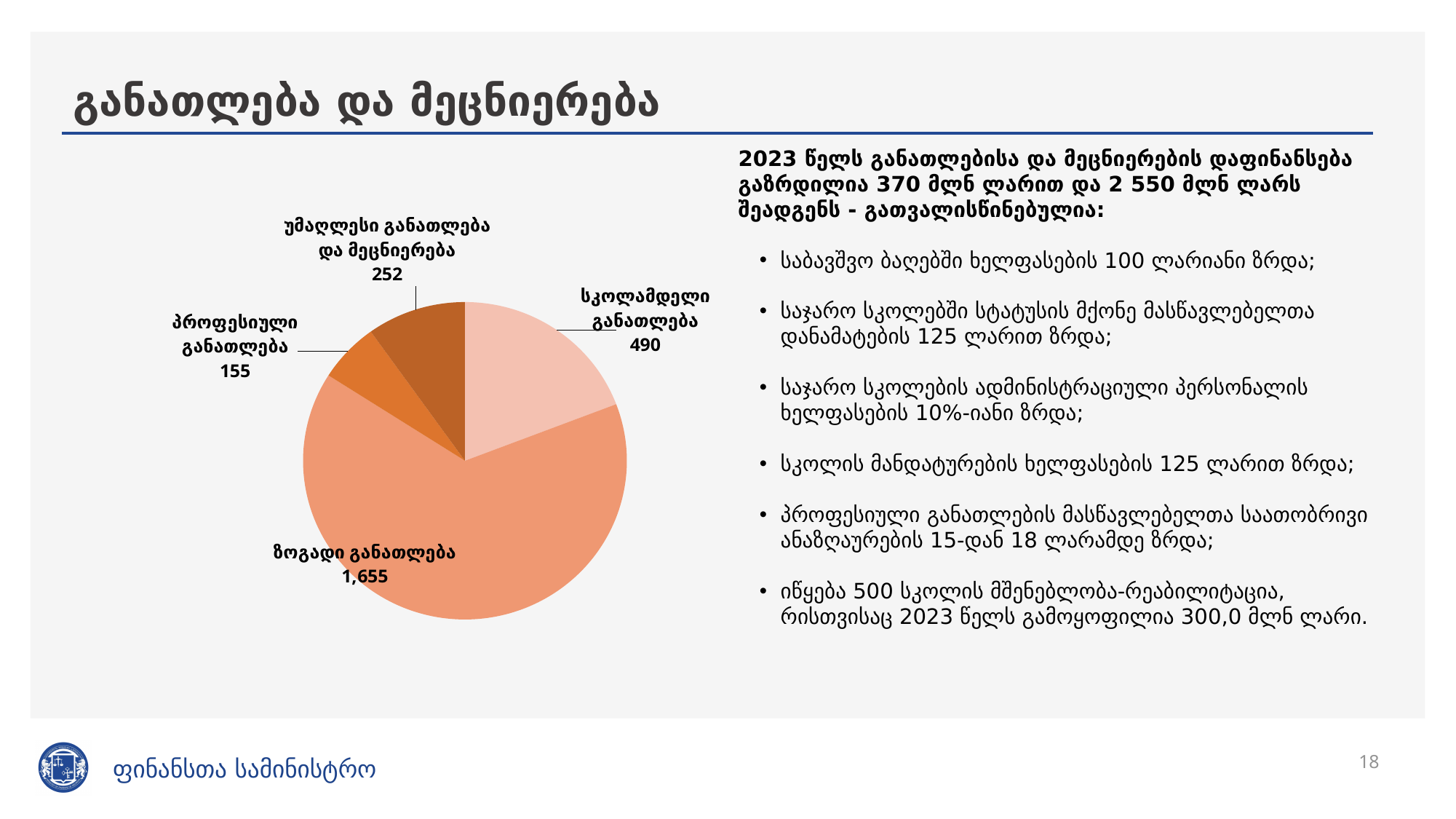
What is the value for პროფესიული განათლება in the pie chart? 155 What is the value for უმაღლესი განათლება და მეცნიერება in the pie chart? 252 Which category has the smallest slice in the pie chart? პროფესიული განათლება How many slices does the pie chart have? 4 What is the difference between the values for ზოგადი განათლება and სკოლამდელი განათლება? 1,165 What is the value for სკოლამდელი განათლება in the pie chart? 490 Which category has the largest slice in the pie chart? ზოგადი განათლება Which is larger: უმაღლესი განათლება და მეცნიერება or პროფესიული განათლება? უმაღლესი განათლება და მეცნიერება What type of chart is shown on the slide? pie chart What is the value for ზოგადი განათლება in the pie chart? 1,655 What is the total of all four slices in the pie chart? 2,552 What is the difference between the values for უმაღლესი განათლება და მეცნიერება and პროფესიული განათლება? 97